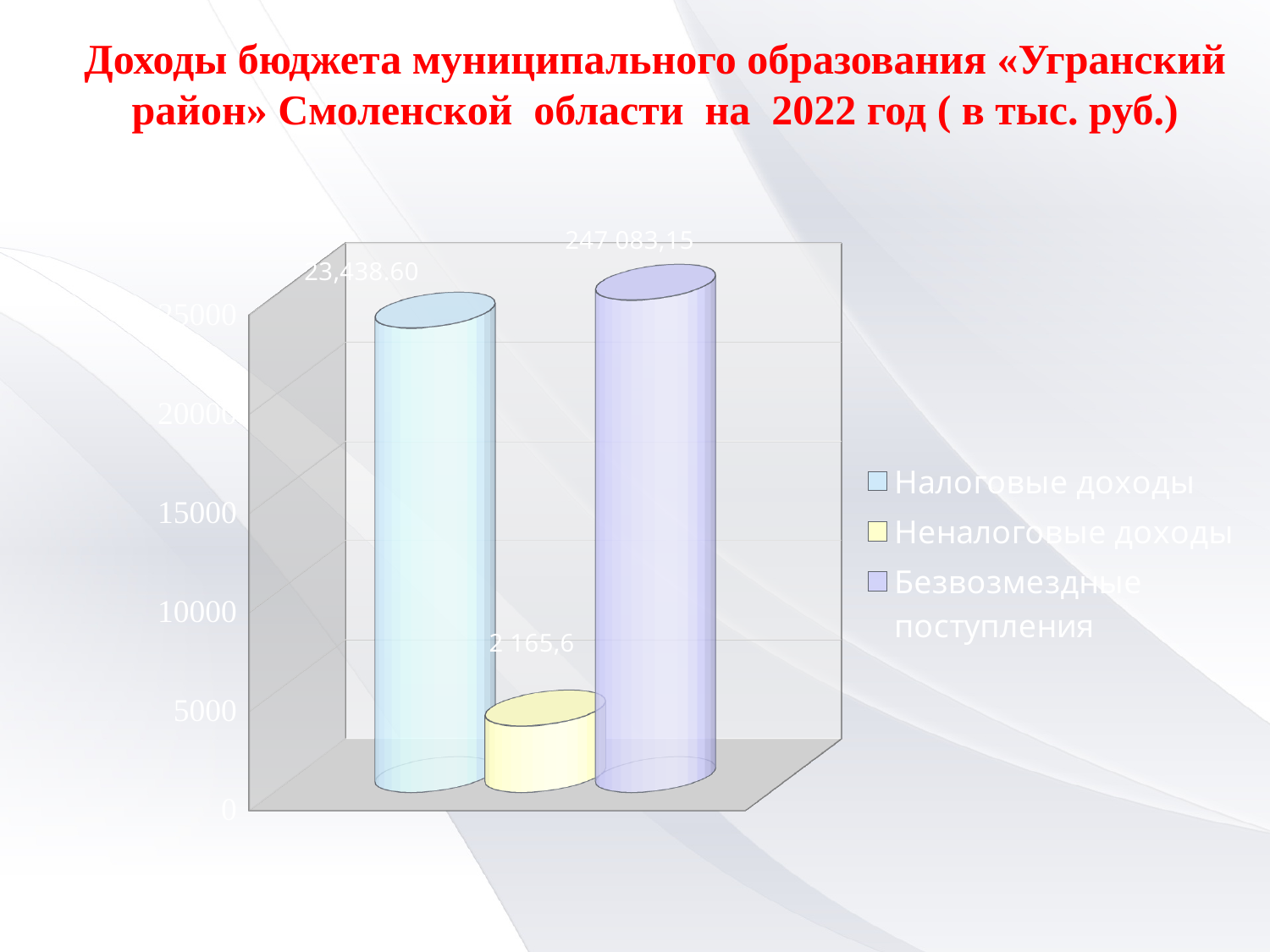
How many series does the legend list? 3 Is the value for Налоговые доходы greater or less than 20000? greater What kind of chart is shown on the slide? Bar chart In what units are the values on the chart given, according to the slide title? тыс. руб. Which is larger, Налоговые доходы or Неналоговые доходы? Налоговые доходы Which series has the highest value? Безвозмездные поступления Which series has the lowest value? Неналоговые доходы What is the value shown for Неналоговые доходы? 2 165,6 How many bars are plotted on the chart? 3 Is the value for Неналоговые доходы greater or less than 5000? less What is the value shown for Налоговые доходы? 23,438.60 What is the value shown for Безвозмездные поступления? 247 083,15